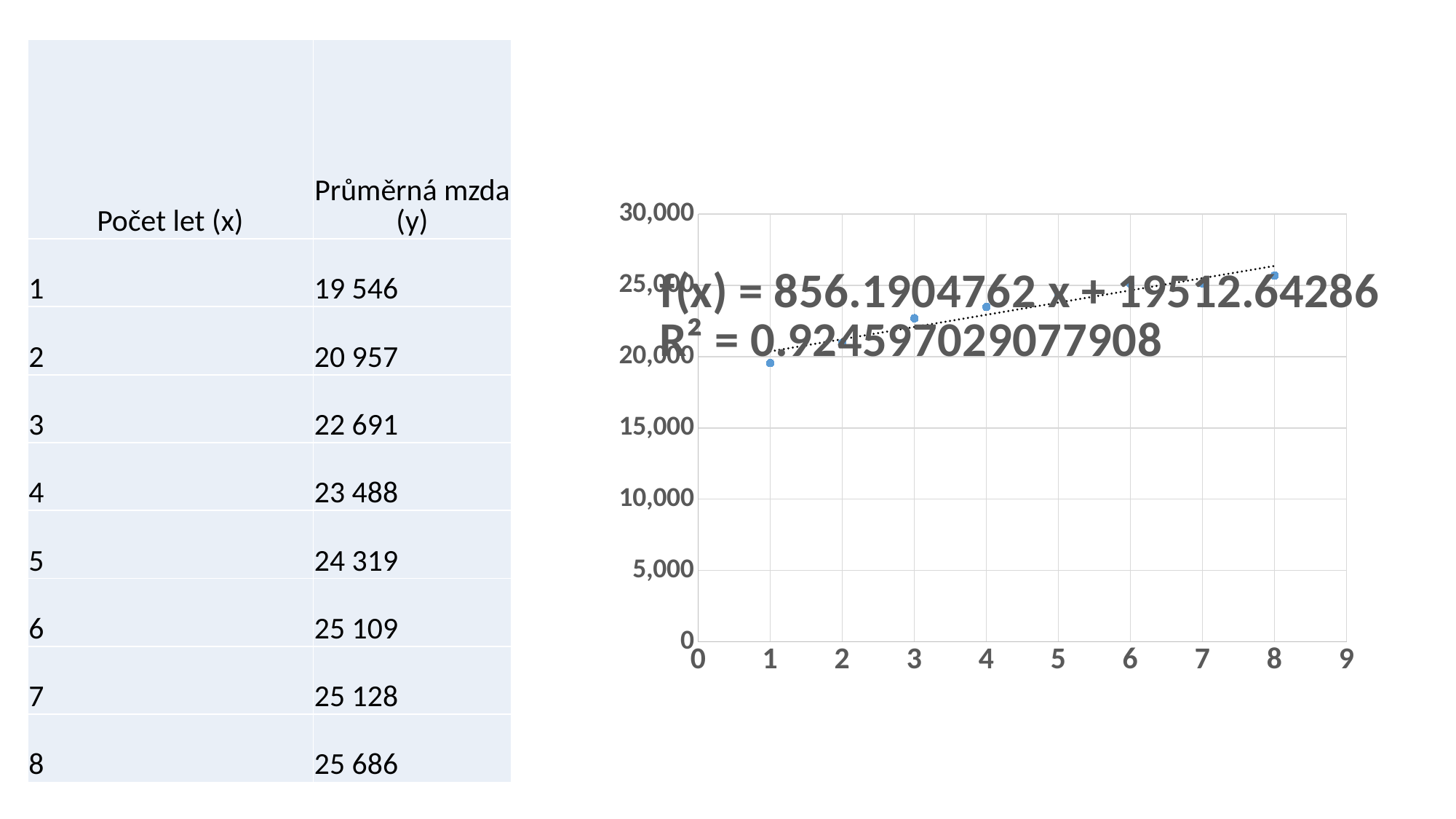
Is the plotted value at x = 4 greater or less than 20,000? greater Is the plotted value at x = 8 greater or less than 25,000? greater How many data points are plotted in the chart? 8 Is the plotted value at x = 1 greater or less than 20,000? less Do the plotted values rise or fall as x increases from 1 to 8? rise What R² value is displayed on the chart? 0.924597029077908 What kind of chart is shown on the slide? scatter chart What is the trendline equation displayed on the chart? f(x) = 856.1904762 x + 19512.64286 Using the table values, what is the difference between the average wage at x = 8 and at x = 1? 6 140 According to the table, which number of years (x) has the lowest average wage? 1 According to the table, what is the average wage (Průměrná mzda) for 3 years (x = 3)? 22 691 According to the table, which number of years (x) has the highest average wage? 8